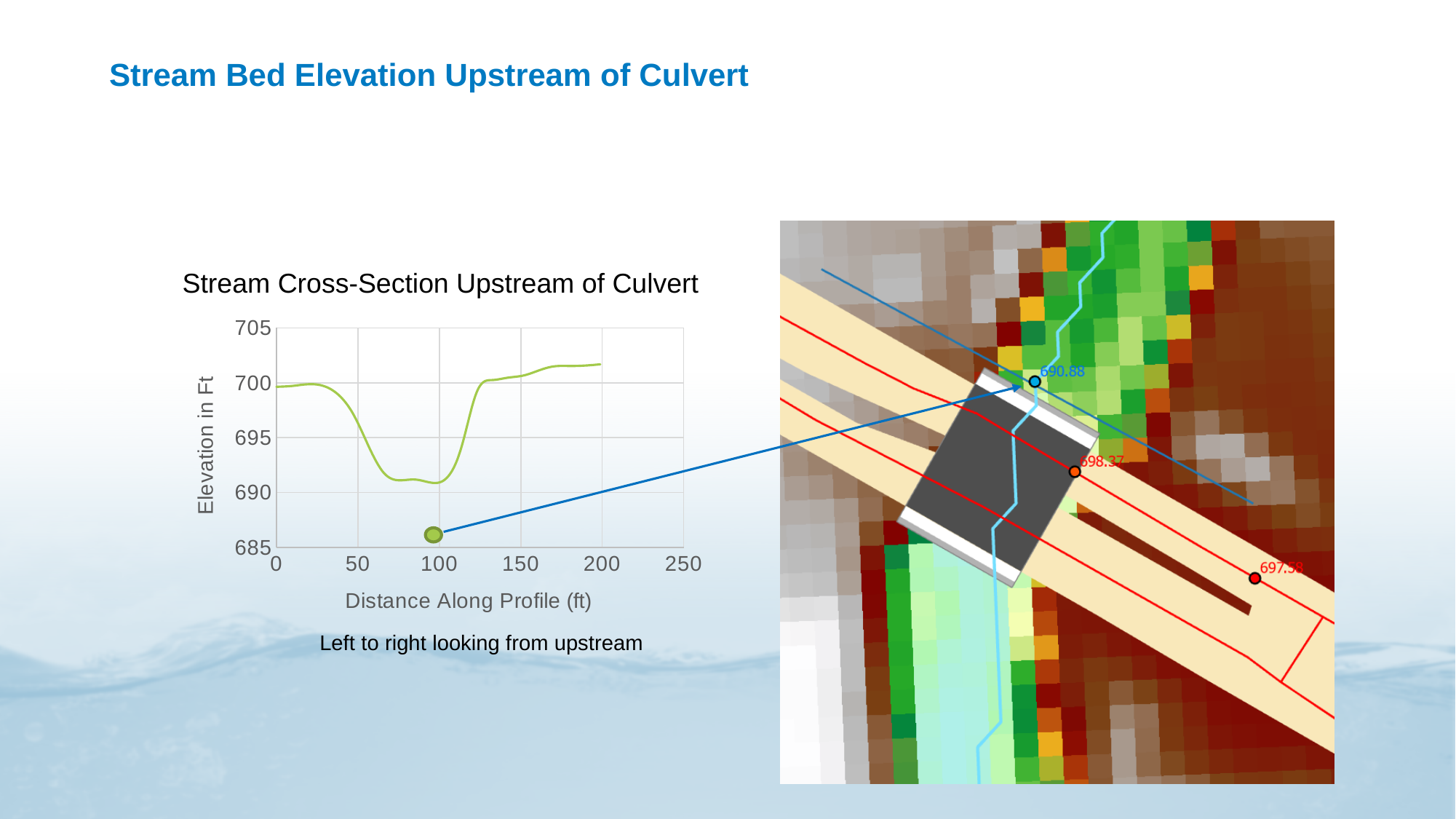
On the Stream Cross-Section chart, is the elevation at 100 ft greater or less than 695? less On the Stream Cross-Section chart, which is higher: the elevation at 200 ft or the elevation at 75 ft? 200 ft What is the title of the chart on the left of the slide? Stream Cross-Section Upstream of Culvert On the Stream Cross-Section chart, does the elevation rise or fall between 25 ft and 75 ft? fall On the Stream Cross-Section chart, is the elevation at 75 ft greater or less than 695? less On the Stream Cross-Section chart, is the elevation at 0 ft greater or less than 695? greater How many lines (series) are plotted on the Stream Cross-Section chart? 1 On the Stream Cross-Section chart, which is higher: the elevation at 0 ft or the elevation at 100 ft? 0 ft What kind of chart is the Stream Cross-Section Upstream of Culvert chart? line chart What is the label of the x axis of the Stream Cross-Section chart? Distance Along Profile (ft) On the Stream Cross-Section chart, does the elevation rise or fall between 100 ft and 150 ft? rise